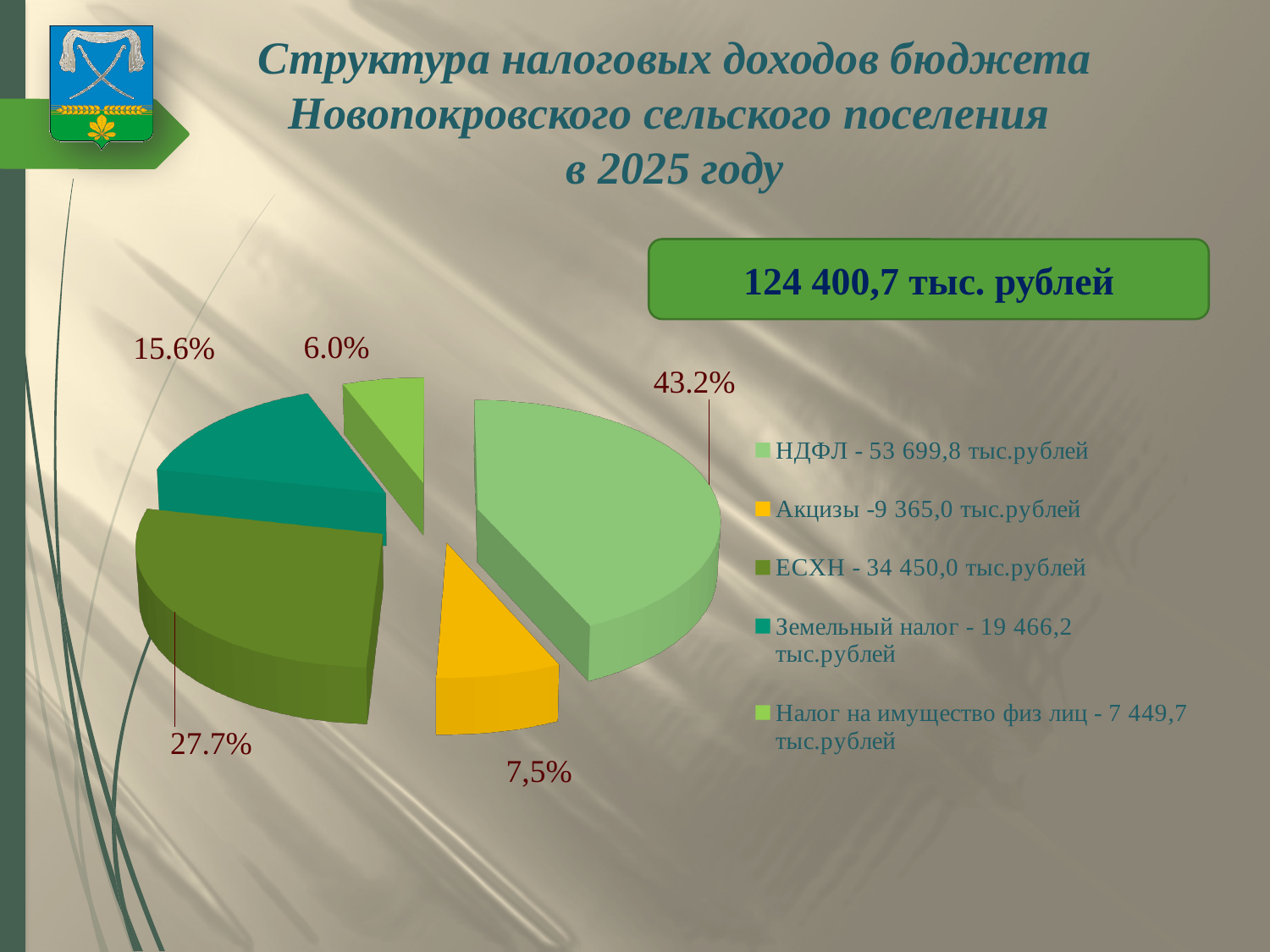
How many entries does the legend list? 5 What share of the pie does Налог на имущество физ лиц represent? 6.0% Which category has the smallest slice of the pie? Налог на имущество физ лиц What total amount is shown in the green box above the chart? 124 400,7 тыс. рублей Which category has the largest slice of the pie? НДФЛ What share of the pie does НДФЛ represent? 43.2% What amount is listed in the legend for ЕСХН? 34 450,0 тыс.рублей What share of the pie does Акцизы represent? 7,5% What kind of chart is shown on the slide? pie chart How many slices does the pie chart have? 5